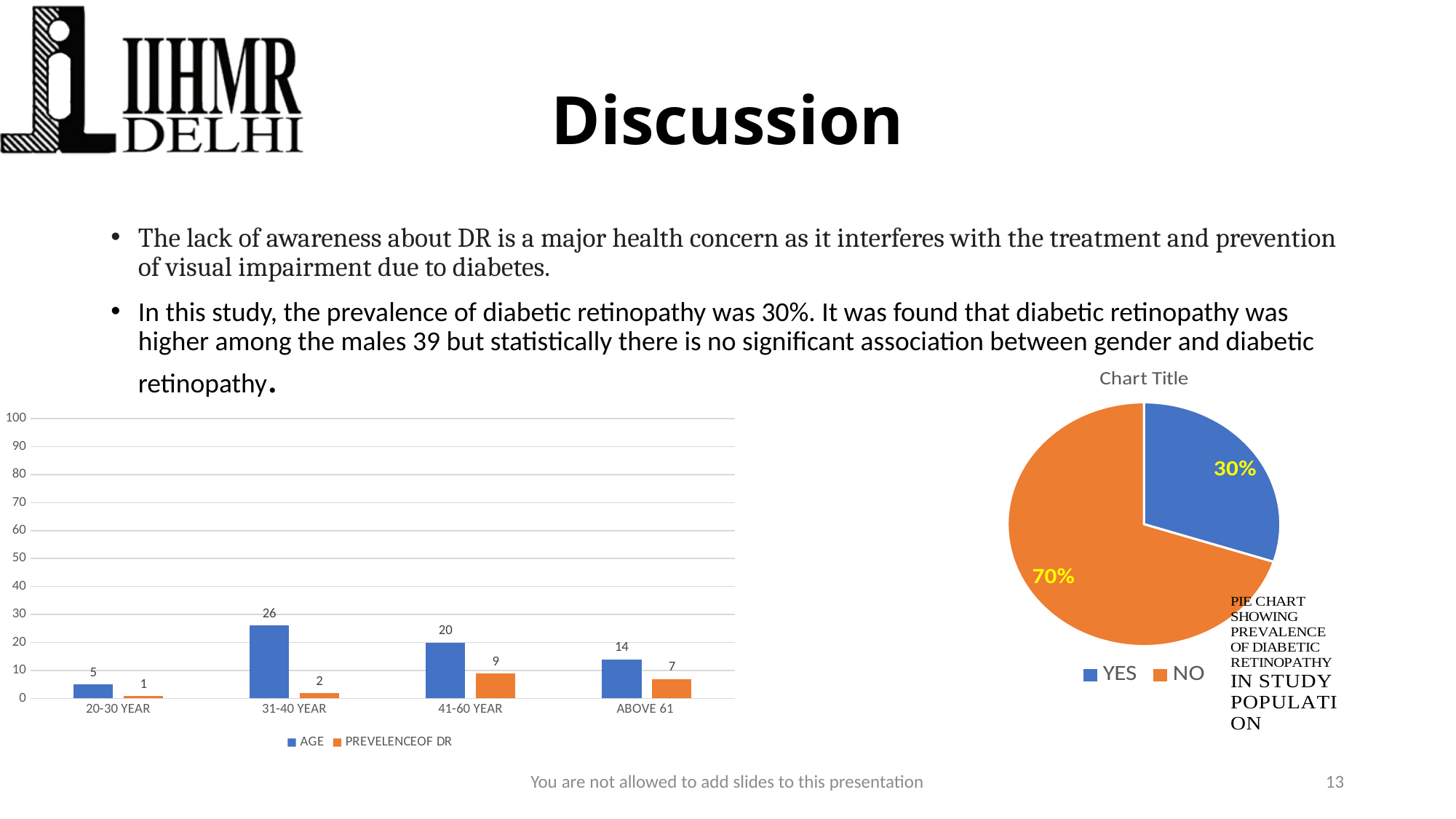
How many age categories are shown on the x axis of the bar chart on the left? 4 In the pie chart on the right, what share does the YES slice have? 30% What kind of chart is the chart on the right titled 'Chart Title'? pie chart In the bar chart on the left, is the AGE value for 41-60 YEAR greater or less than 30? less In the bar chart on the left, which is larger: the PREVELENCEOF DR value for 41-60 YEAR or for ABOVE 61? 41-60 YEAR In the bar chart on the left, what is the PREVELENCEOF DR value for the 41-60 YEAR category? 9 How many series does the legend of the bar chart on the left list? 2 In the bar chart on the left, which age category has the highest AGE value? 31-40 YEAR In the bar chart on the left, what is the AGE value for the 31-40 YEAR category? 26 In the bar chart on the left, which age category has the lowest PREVELENCEOF DR value? 20-30 YEAR In the pie chart on the right, which slice is larger, YES or NO? NO In the bar chart on the left, what is the difference between the AGE value and the PREVELENCEOF DR value for the ABOVE 61 category? 7